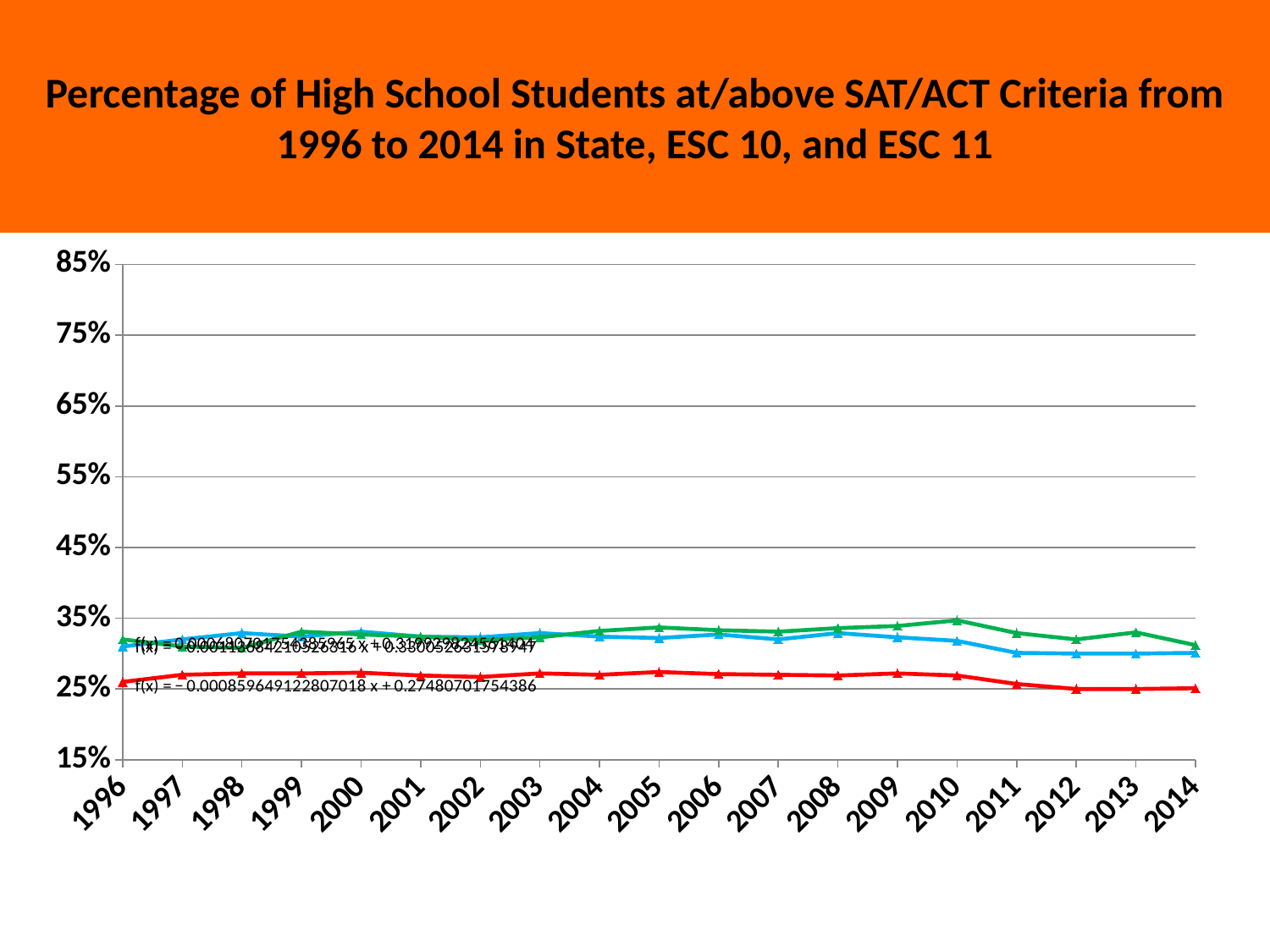
Is the value of the red line in 2005 greater or less than 25%? greater In which year does the green line reach its highest value? 2010 Is the value of the red line in 2014 greater or less than 35%? less In 2010, which line has the larger value, the green line or the red line? green line How many years are shown along the x axis of the chart? 19 How many lines are plotted on the chart? 3 Is the value of the blue line in 2012 greater or less than 25%? greater What kind of chart is shown on the slide? line chart Does the red line rise or fall between 2009 and 2012? fall What is the highest value shown on the y axis? 85% What is the first year shown on the x axis? 1996